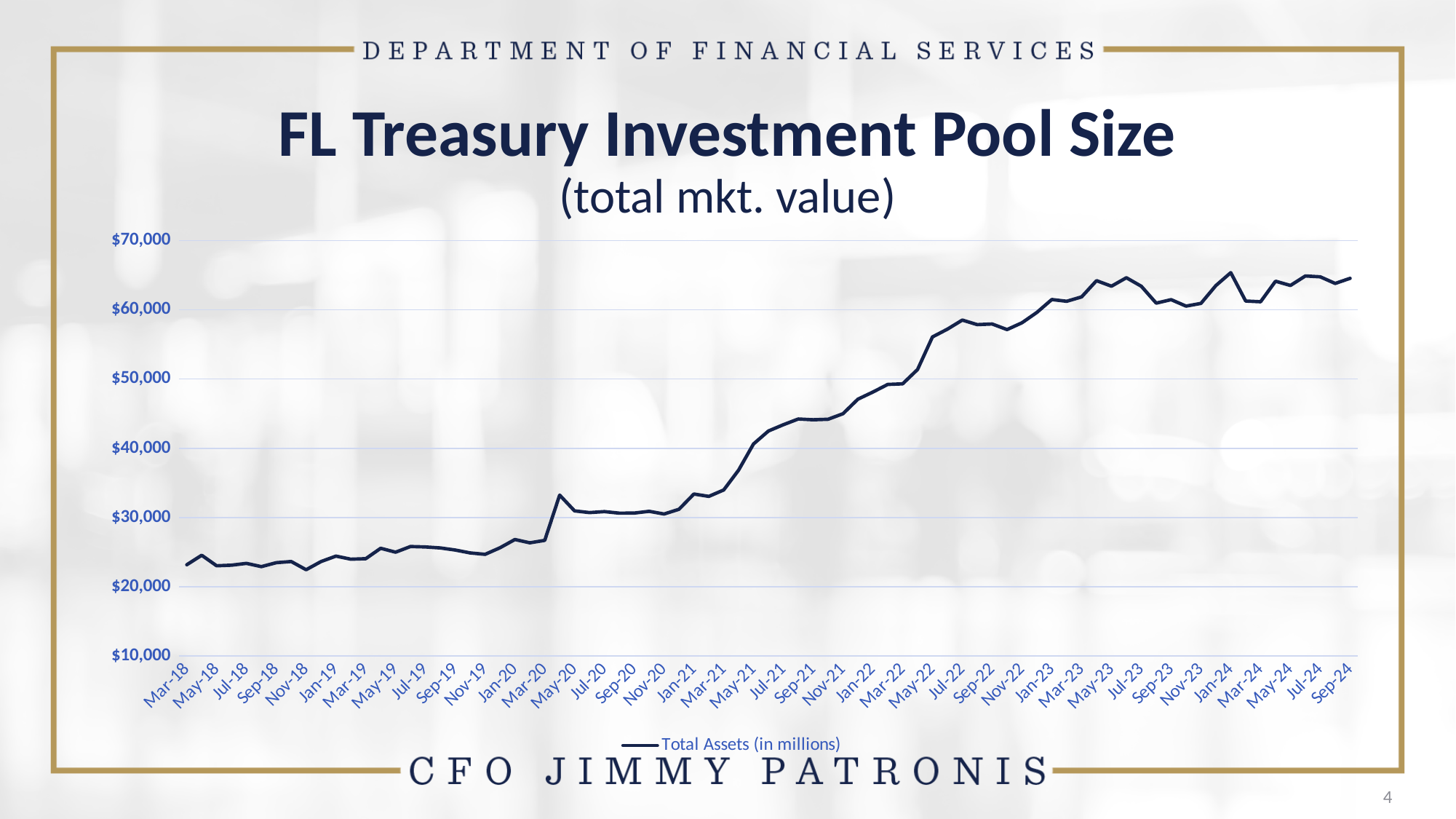
Is the value for Jul-22 greater or less than $50,000? greater Is the value for Mar-20 greater or less than $30,000? less How many series does the legend list? 1 Which is larger, the value for Jan-20 or the value for Jul-22? Jul-22 Which is larger, the value for Sep-24 or the value for Mar-18? Sep-24 What is the title of the chart? FL Treasury Investment Pool Size (total mkt. value) Overall, do the values rise or fall from Mar-18 to Sep-24? rise Is the value for Mar-18 greater or less than $30,000? less What kind of chart is shown on the slide? line chart What is the name of the series shown in the legend? Total Assets (in millions)